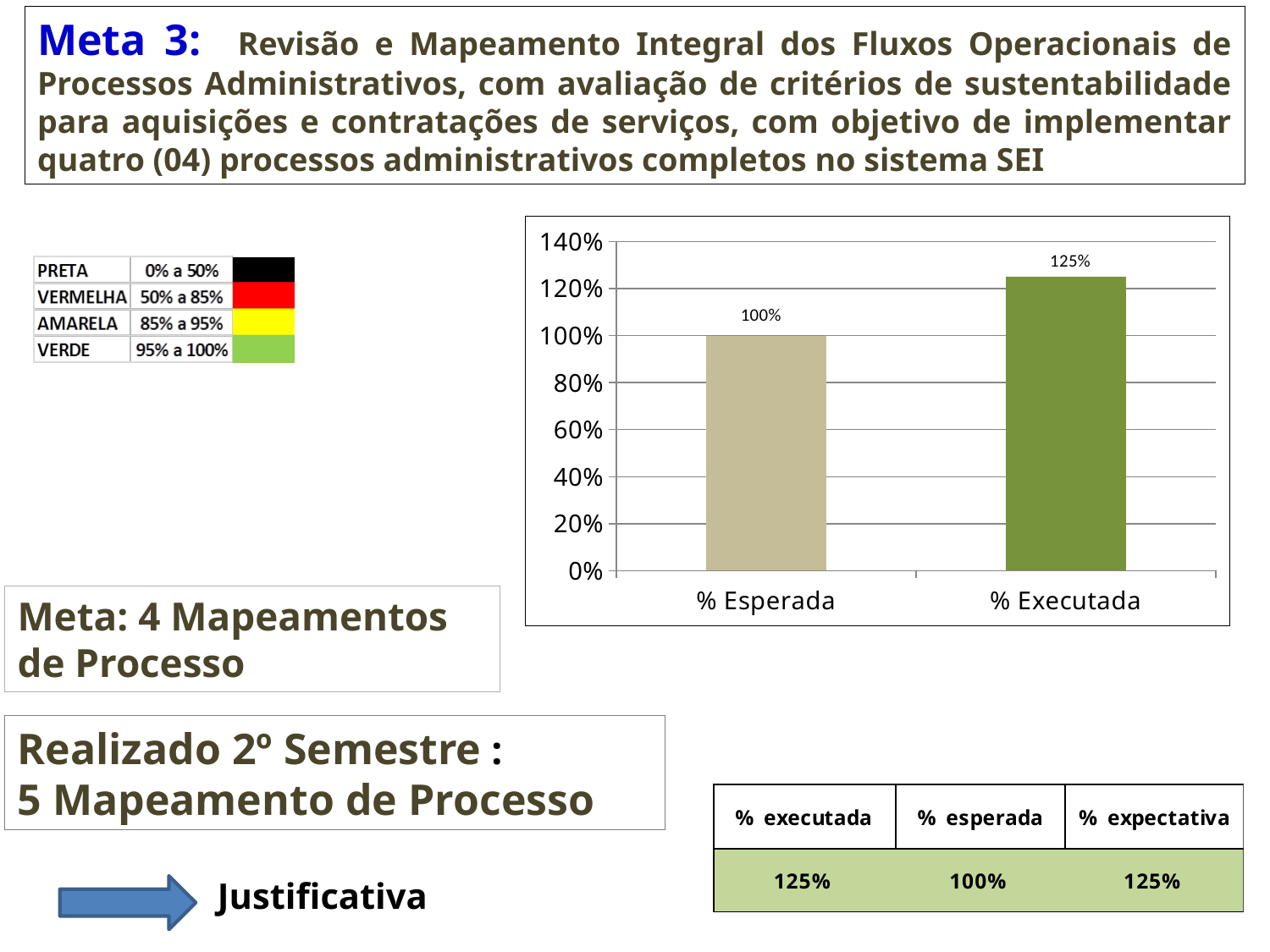
Is the value for % Esperada greater or less than 120%? less What kind of chart is shown? bar chart Which category has the highest value? % Executada What is the value for % Executada? 125% What is the value for % Esperada? 100% What is the difference between % Executada and % Esperada? 25% What is the highest value shown on the y axis? 140% What colour is the bar for % Executada? green How many categories are shown on the x axis? 2 Which is larger, % Esperada or % Executada? % Executada Is the value for % Executada greater or less than 120%? greater Which category has the lowest value? % Esperada